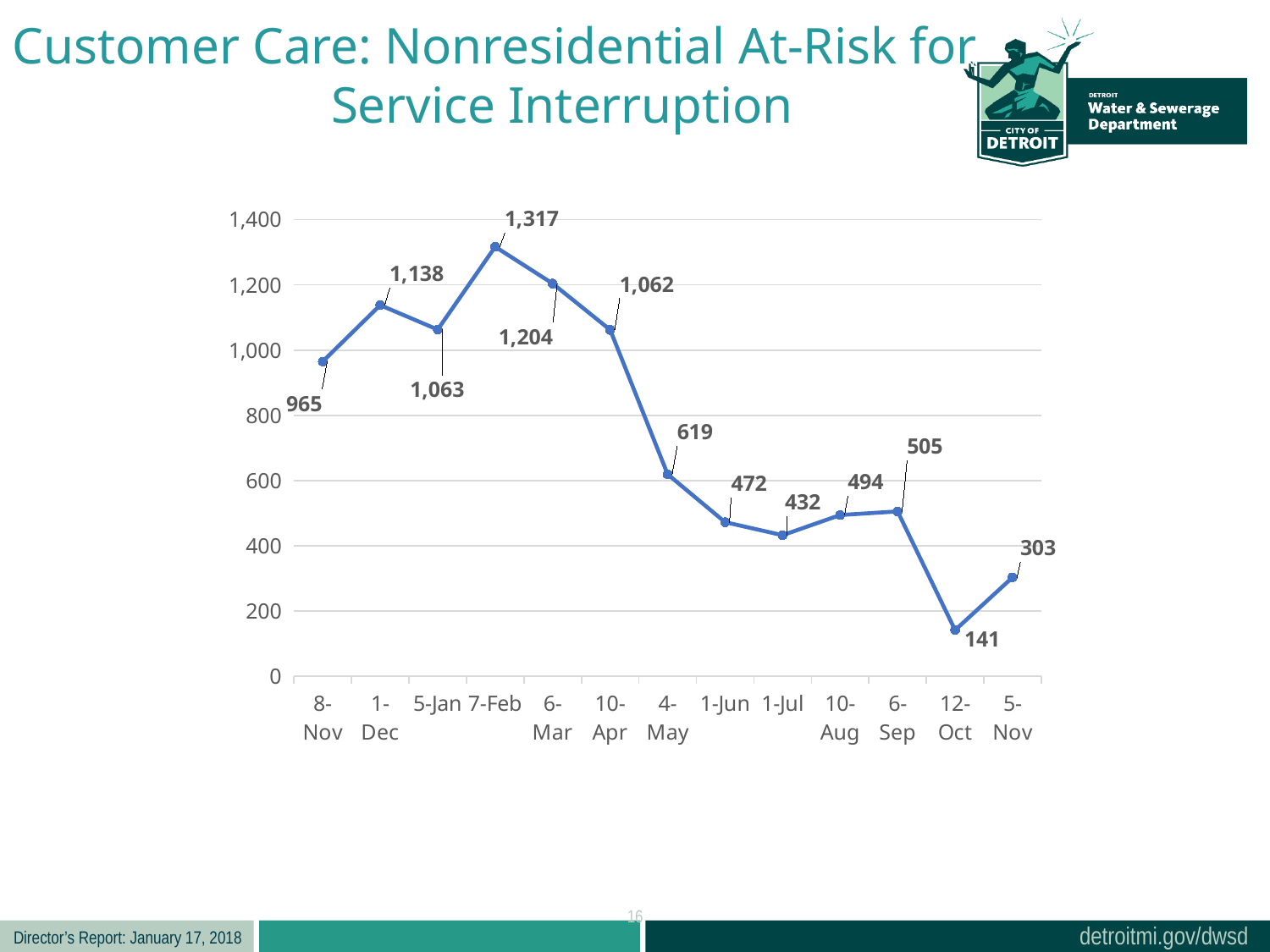
Which date has the highest value? 7-Feb What is the value for 12-Oct? 141 Which is larger, the value for 1-Dec or the value for 6-Mar? 6-Mar Which date has the lowest value? 12-Oct What type of chart is shown on the slide? Line chart What is the value for 4-May? 619 How many data points are plotted on the chart? 13 What is the difference between the values for 7-Feb and 12-Oct? 1,176 What is the title of the slide containing the chart? Customer Care: Nonresidential At-Risk for Service Interruption What is the value for 7-Feb? 1,317 Do the values generally rise or fall from 10-Apr to 1-Jul? Fall What is the value for 5-Nov? 303